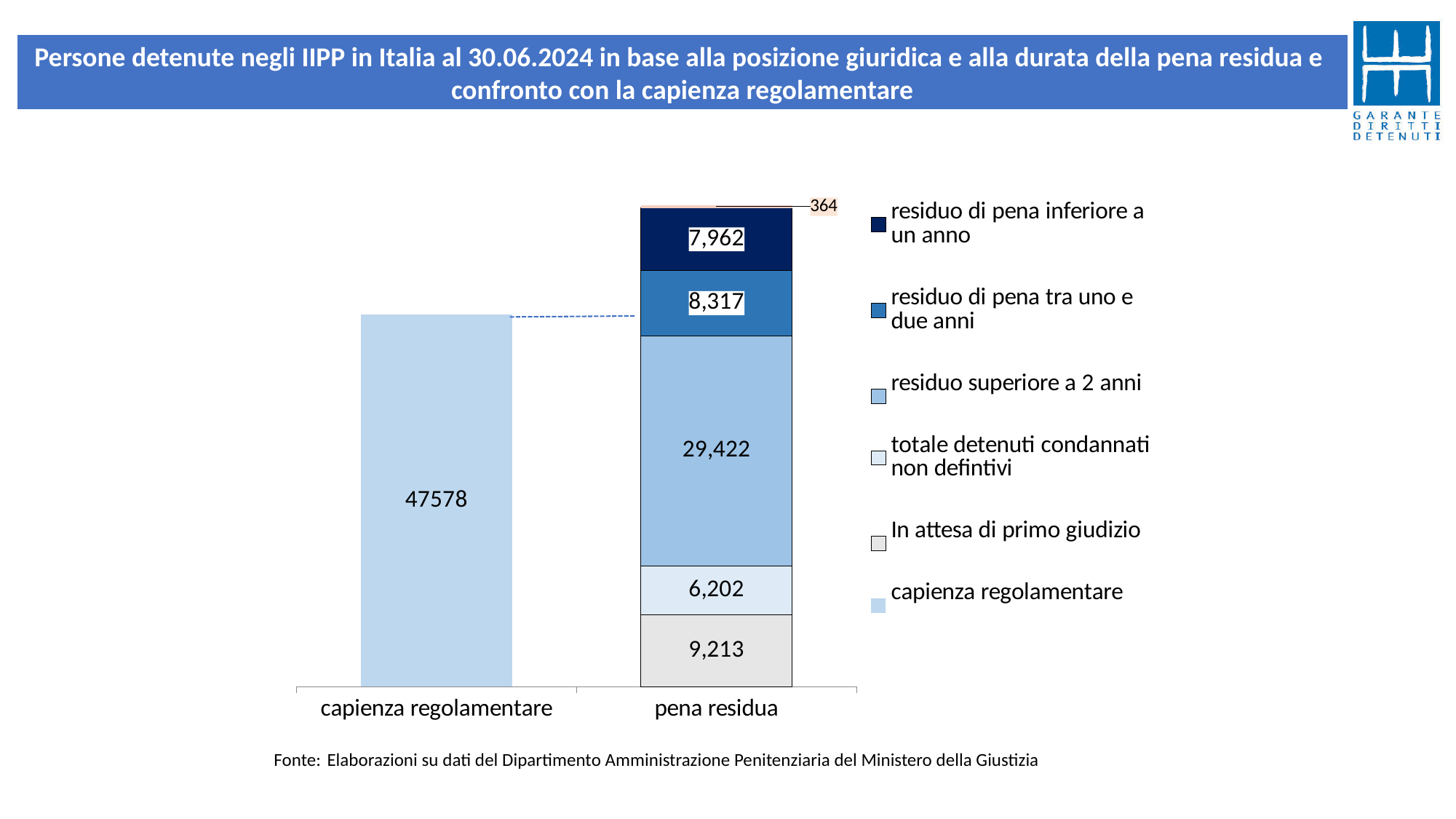
What is the difference between In attesa di primo giudizio (9,213) and totale detenuti condannati non defintivi (6,202)? 3,011 Which is larger: residuo di pena tra uno e due anni or residuo di pena inferiore a un anno? residuo di pena tra uno e due anni What kind of chart is shown on the slide? stacked bar chart How many categories are shown on the x axis? 2 In the pena residua bar, what is the value for In attesa di primo giudizio? 9,213 Which segment of the pena residua bar is the largest? residuo superiore a 2 anni How many entries does the legend list? 6 What is the value shown for capienza regolamentare? 47578 In the pena residua bar, what is the value for residuo superiore a 2 anni? 29,422 In the pena residua bar, what is the value for totale detenuti condannati non defintivi? 6,202 In the pena residua bar, what is the value for residuo di pena inferiore a un anno? 7,962 What is the difference between residuo superiore a 2 anni (29,422) and residuo di pena tra uno e due anni (8,317)? 21,105